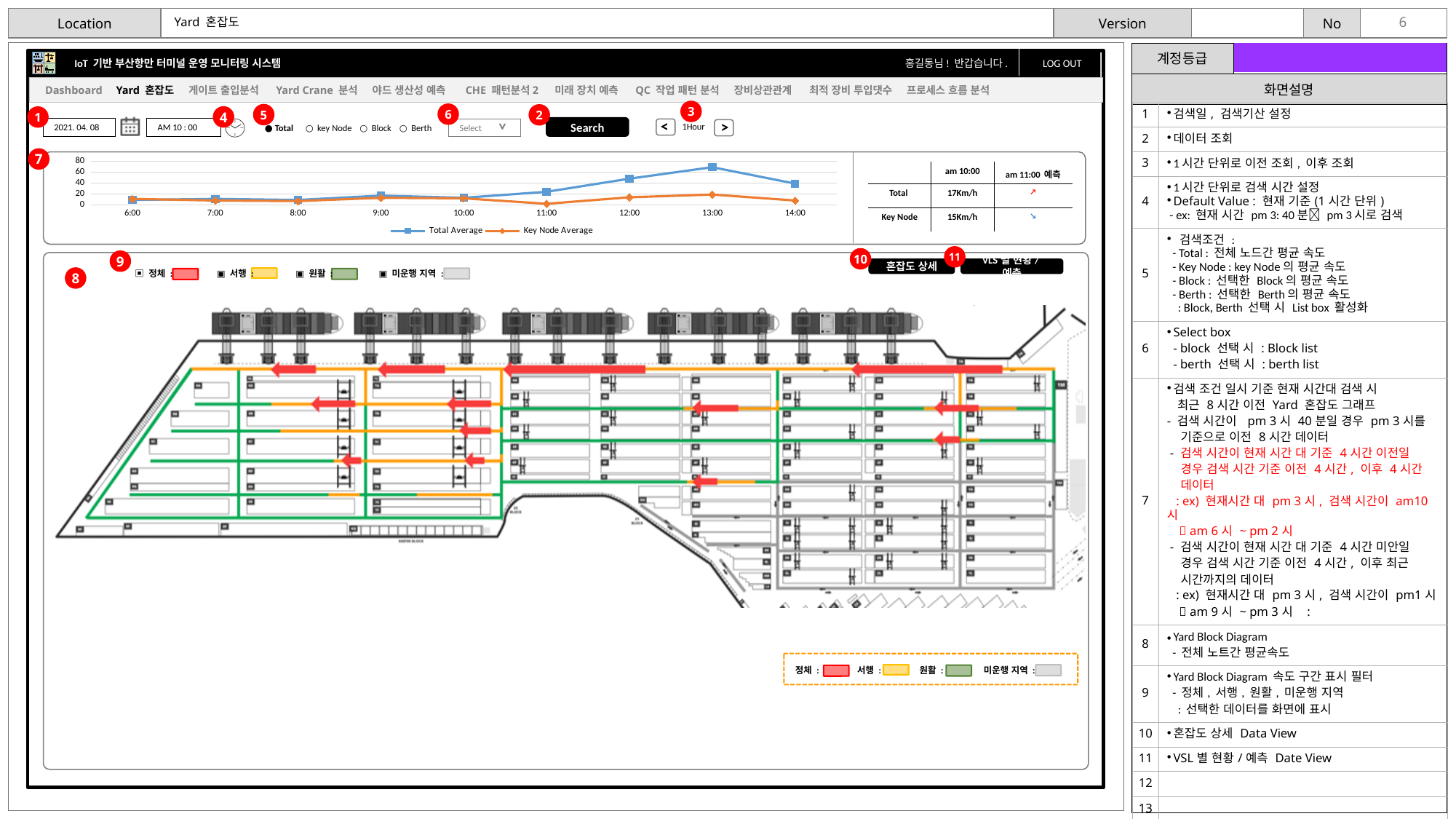
Does the Total Average series rise or fall between 11:00 and 13:00? rise At which time does the Total Average series reach its highest value? 13:00 What is the highest value shown on the y axis of the line chart? 80 What kind of chart is shown at the top of the slide? line chart Is the Key Node Average value at 13:00 greater or less than 40? less How many series does the legend of the line chart list? 2 How many time points are plotted along the x axis of the line chart? 9 At 13:00, which series has the larger value, Total Average or Key Node Average? Total Average Does the Total Average series rise or fall between 13:00 and 14:00? fall Is the Total Average value at 13:00 greater or less than 60? greater What are the two series named in the line chart's legend? Total Average and Key Node Average Is the Total Average value at 6:00 greater or less than 20? less